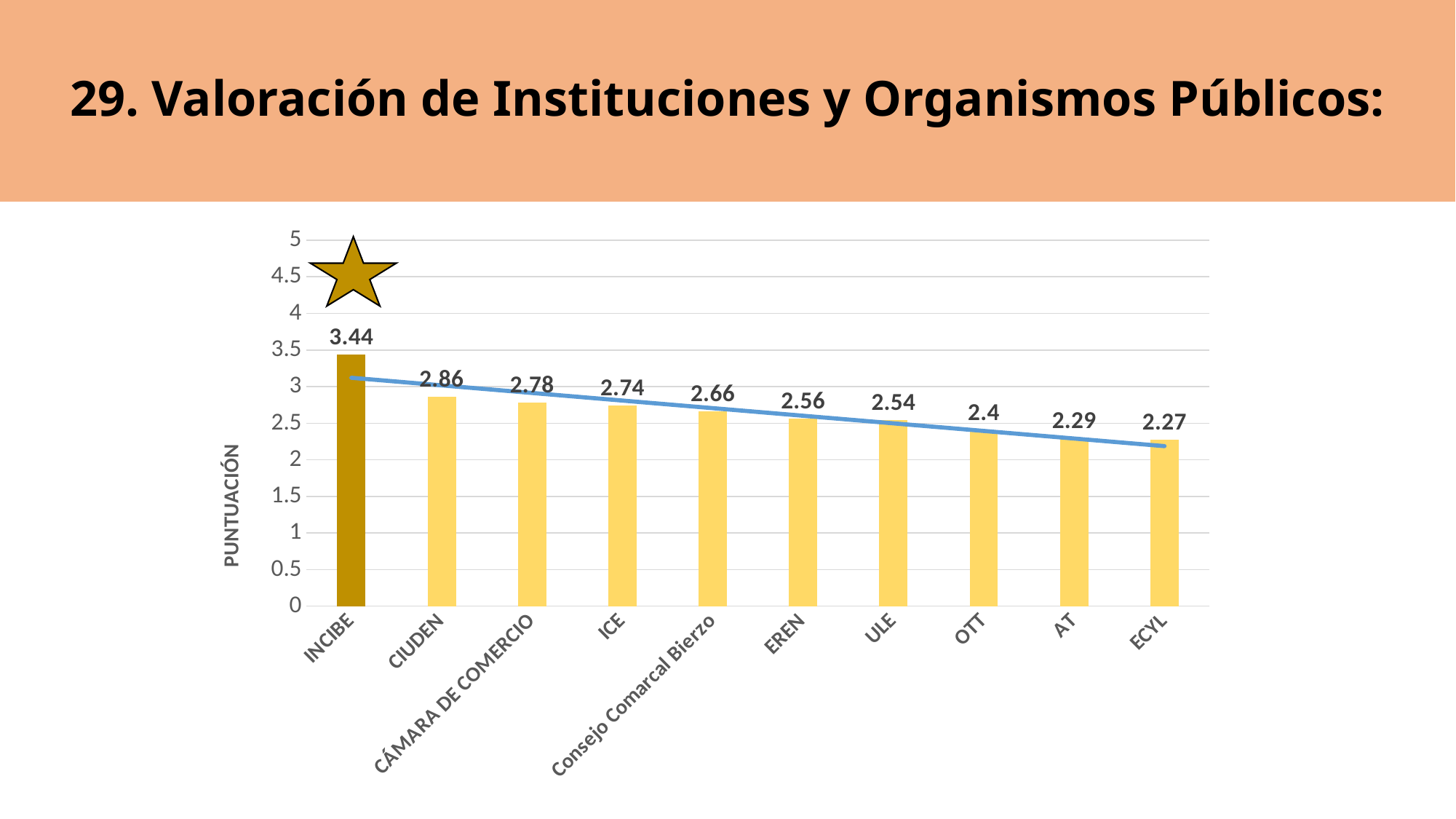
What is the difference between the values for INCIBE and CIUDEN? 0.58 Which category has the lowest value? ECYL How many categories are shown on the x axis? 10 Which category has the highest value? INCIBE Do the values rise or fall from left to right along the x axis? fall What is the value for INCIBE? 3.44 Is the value for AT greater or less than 2.5? less What is the value for Consejo Comarcal Bierzo? 2.66 What is the value for OTT? 2.4 What kind of chart is this? bar chart Which is larger, the value for ICE or the value for EREN? ICE What is the value for CIUDEN? 2.86